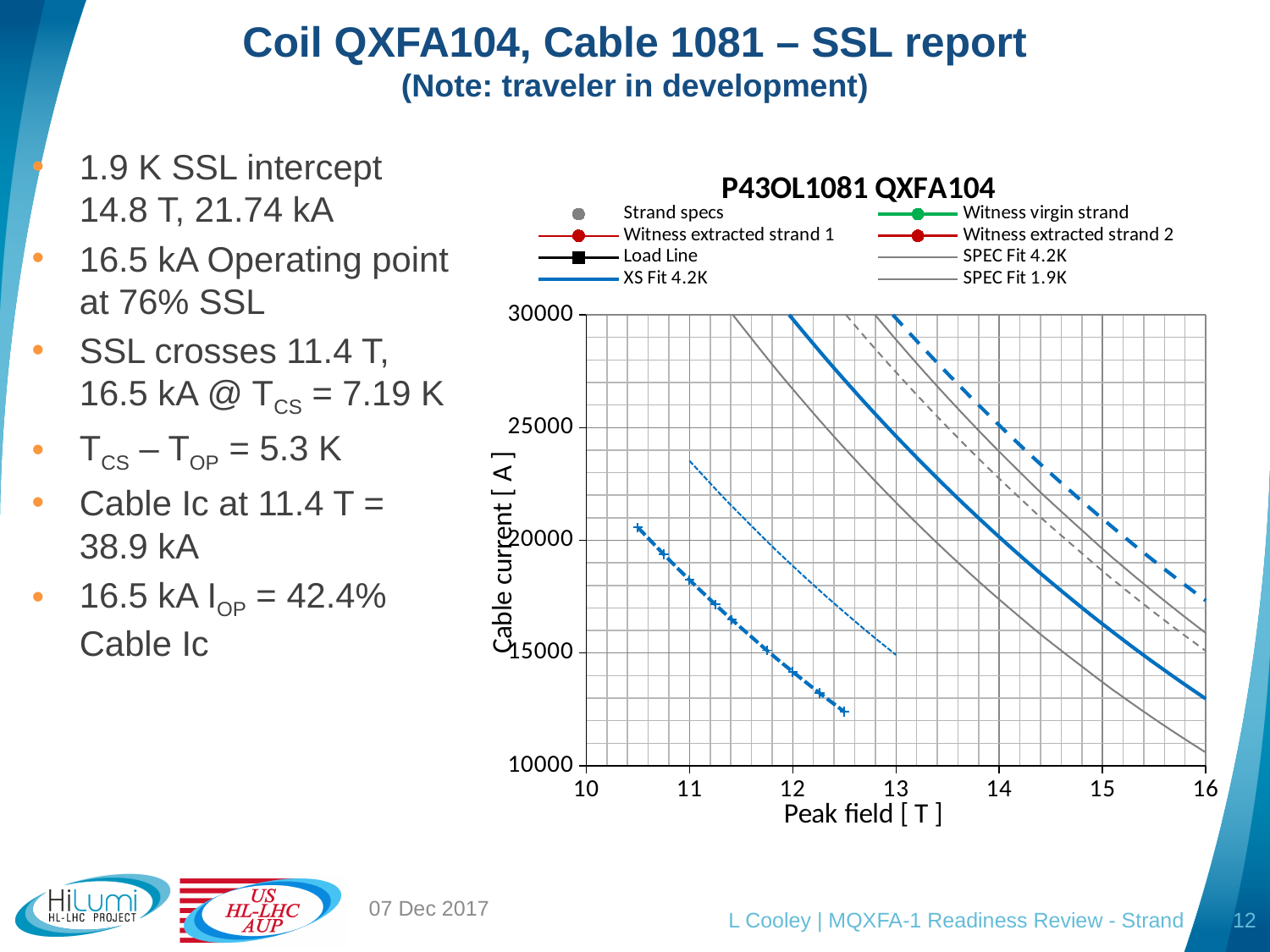
Is the XS Fit 4.2K value at 16 T greater or less than 15000? less What is the label of the chart's x axis? Peak field [ T ] What kind of chart is shown on the slide? line chart What is the title of the chart? P43OL1081 QXFA104 Is the XS Fit 4.2K value at 13 T greater or less than 20000? greater Do the plotted curves rise or fall as peak field increases along the x axis? fall How many series does the chart legend list? 8